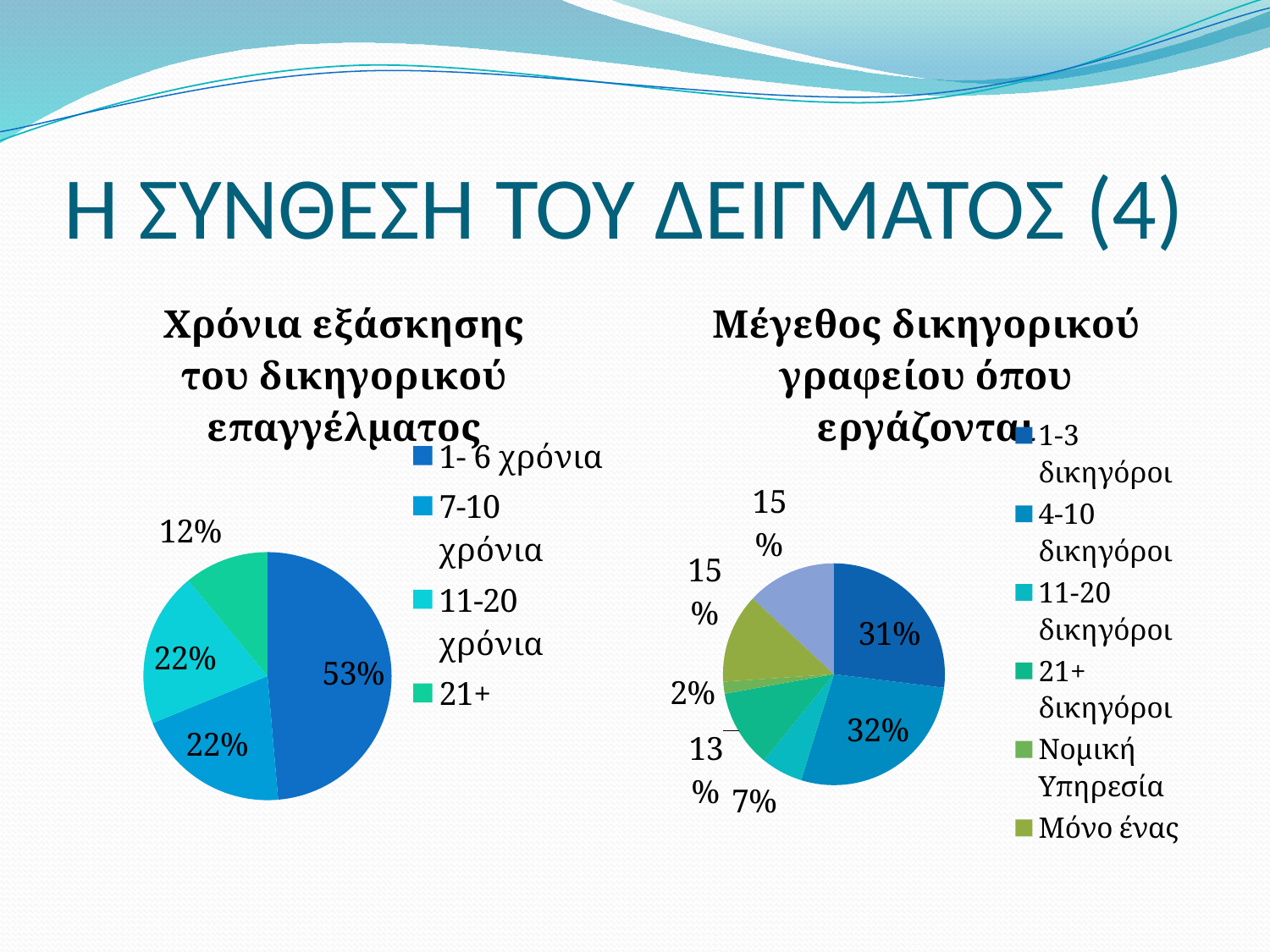
In the left chart (Χρόνια εξάσκησης του δικηγορικού επαγγέλματος), what share of the pie is the 1-6 χρόνια slice? 53% What kind of chart is the right chart (Μέγεθος δικηγορικού γραφείου όπου εργάζονται)? Pie chart In the right chart (Μέγεθος δικηγορικού γραφείου όπου εργάζονται), what is the difference between the 1-3 δικηγόροι slice and the 11-20 δικηγόροι slice? 24% In the right chart (Μέγεθος δικηγορικού γραφείου όπου εργάζονται), what percentage is shown for 4-10 δικηγόροι? 32% In the left chart (Χρόνια εξάσκησης του δικηγορικού επαγγέλματος), what percentage is shown for 21+? 12% In the right chart (Μέγεθος δικηγορικού γραφείου όπου εργάζονται), which is larger: the slice for 11-20 δικηγόροι or the slice for 21+ δικηγόροι? 21+ δικηγόροι In the right chart (Μέγεθος δικηγορικού γραφείου όπου εργάζονται), what percentage is shown for Νομική Υπηρεσία? 2% In the right chart (Μέγεθος δικηγορικού γραφείου όπου εργάζονται), which category has the smallest slice? Νομική Υπηρεσία In the left chart (Χρόνια εξάσκησης του δικηγορικού επαγγέλματος), which category has the smallest slice? 21+ In the left chart (Χρόνια εξάσκησης του δικηγορικού επαγγέλματος), what is the difference between the 1-6 χρόνια slice and the 7-10 χρόνια slice? 31% In the left chart (Χρόνια εξάσκησης του δικηγορικού επαγγέλματος), which category has the largest slice? 1-6 χρόνια How many entries does the legend of the left chart (Χρόνια εξάσκησης του δικηγορικού επαγγέλματος) list? 4